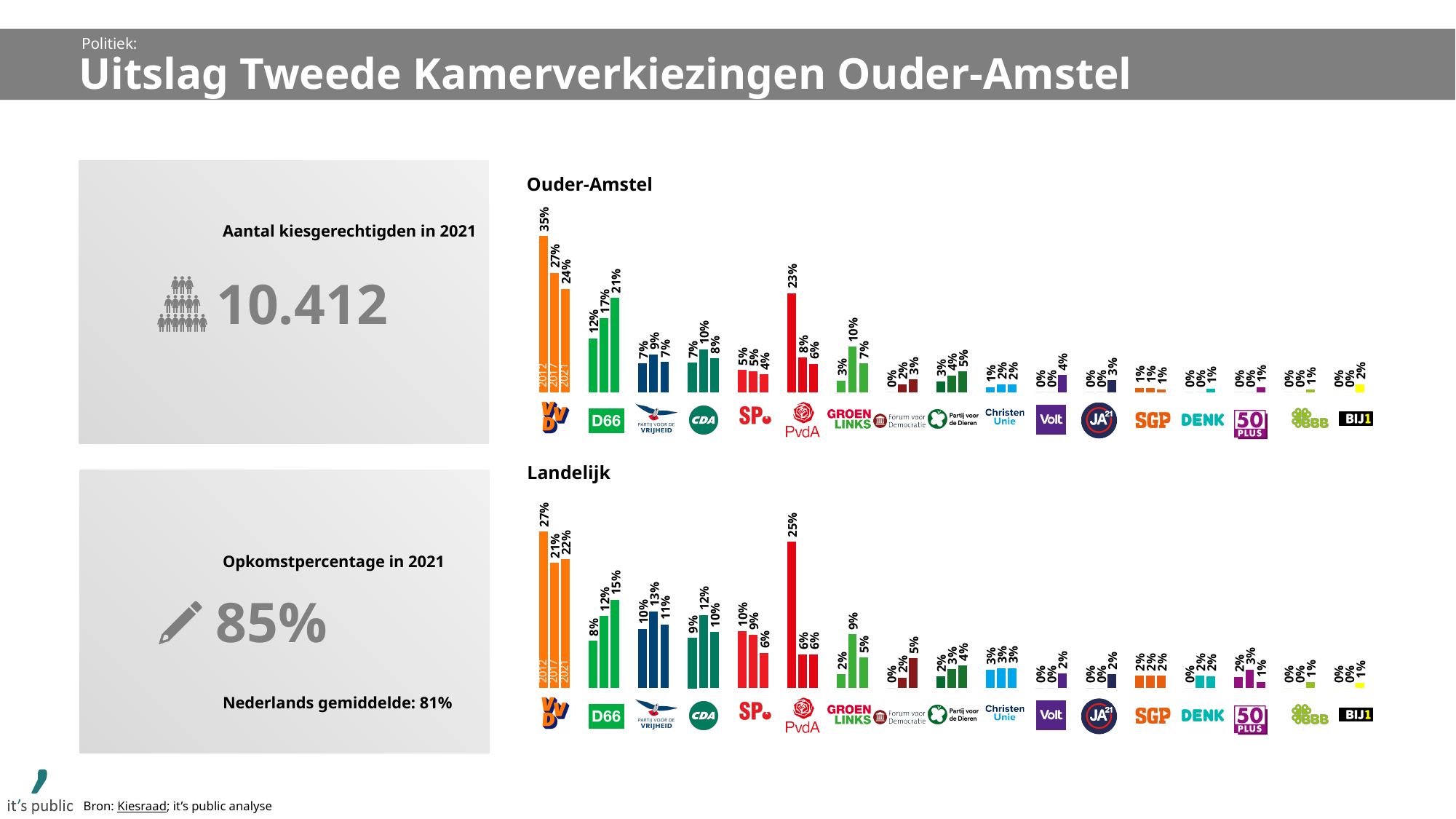
What kind of chart is the Landelijk chart? bar chart In the Landelijk chart, which party has the highest value in 2021? VVD In the Landelijk chart, what percentage did the PVV (Partij voor de Vrijheid) get in 2017? 13% In the Ouder-Amstel chart, what percentage did D66 get in 2017? 17% In the Ouder-Amstel chart, what is the difference between the VVD's 2012 and 2021 percentages? 11% In the Ouder-Amstel chart, which is larger: D66 in 2021 or PvdA in 2021? D66 in 2021 In the Landelijk chart, what percentage did the PvdA get in 2012? 25% In the Landelijk chart, what is the difference between D66's 2021 and 2012 percentages? 7% In the Ouder-Amstel chart, what percentage did the VVD get in 2021? 24% In the Ouder-Amstel chart, do the VVD's values rise or fall from 2012 to 2021? fall In the Ouder-Amstel chart, which party has the highest value in 2012? VVD In the Landelijk chart, do D66's values rise or fall from 2012 to 2021? rise